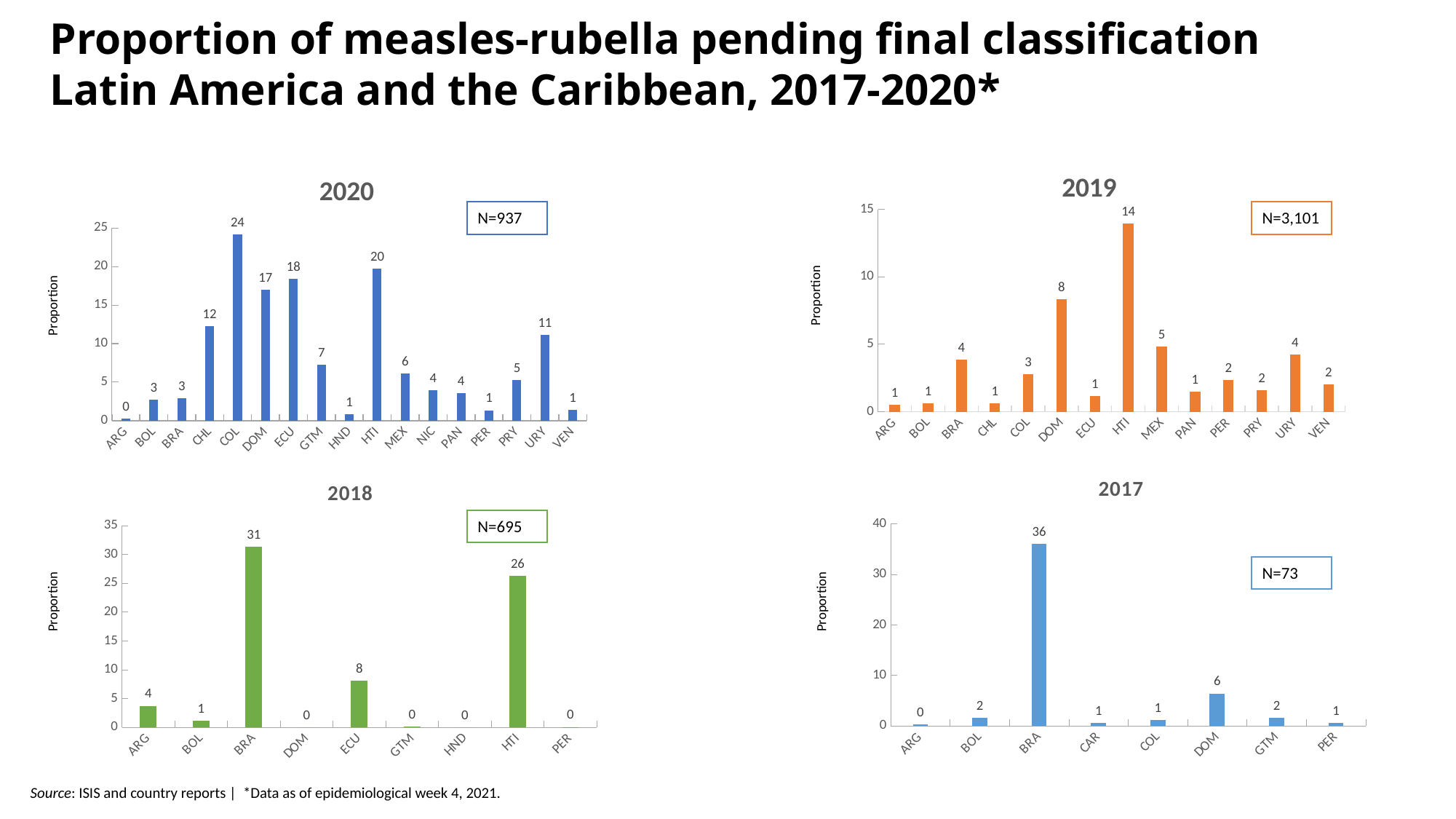
In the 2019 chart, which country has the highest proportion? HTI How many countries are shown on the x axis of the 2018 chart? 9 In the 2018 chart, what is the difference between the values for BRA and HTI? 5 In the 2020 chart, what is the value for COL? 24 How many countries are shown on the x axis of the 2019 chart? 14 What type of chart is the 2017 chart? Bar chart In the 2020 chart, which country has the highest proportion? COL In the 2017 chart, which country has the highest proportion? BRA In the 2017 chart, what is the value for DOM? 6 In the 2019 chart, what is the value for HTI? 14 In the 2020 chart, which is larger, the value for ECU or the value for URY? ECU What is the N value shown in the box on the 2019 chart? N=3,101